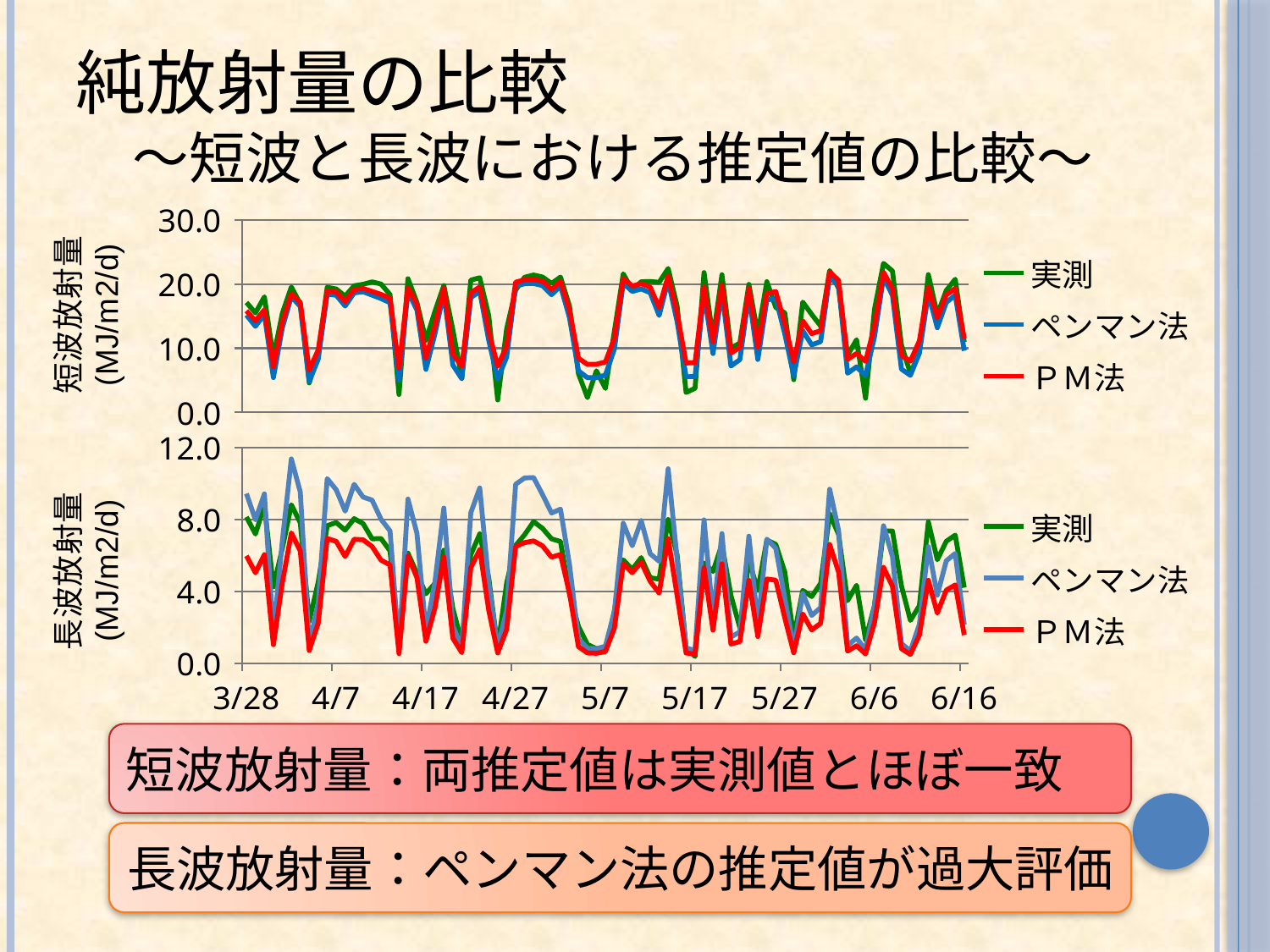
How many series does the legend of the top chart (短波放射量) list? 3 In the top chart (短波放射量), which series is drawn in red? ＰＭ法 How many series does the legend of the bottom chart (長波放射量) list? 3 In the top chart (短波放射量), is the 実測 value at 3/28 greater or less than 10.0? greater What kind of chart is the top chart (短波放射量)? line chart What kind of chart is the bottom chart (長波放射量)? line chart In the bottom chart (長波放射量), is the highest peak of the ペンマン法 series greater or less than 8.0? greater In the bottom chart (長波放射量), is the ＰＭ法 value at 3/28 greater or less than 8.0? less What unit is shown on the y-axis of the bottom chart (長波放射量)? MJ/m2/d How many date labels are shown on the shared x-axis of the charts? 9 In the bottom chart (長波放射量), which series generally has the highest values, ペンマン法 or ＰＭ法? ペンマン法